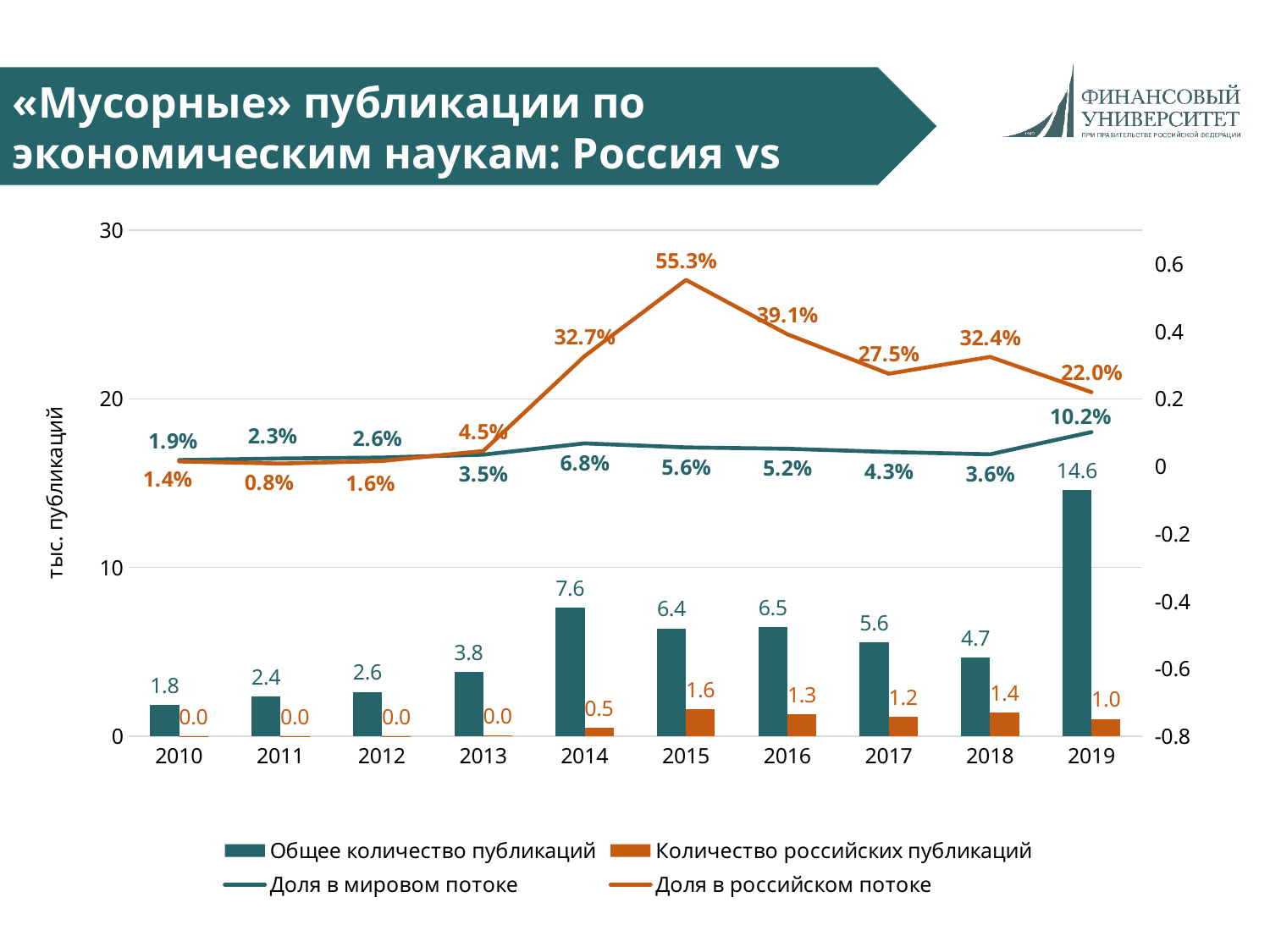
How many series does the legend list? 4 What is the label of the left vertical axis? тыс. публикаций How many years are shown on the x axis? 10 What is the value of «Доля в мировом потоке» for 2014? 6.8% What is the value of «Доля в российском потоке» for 2015? 55.3% What is the value of «Общее количество публикаций» for 2019? 14.6 In which year is «Общее количество публикаций» lowest? 2010 What kind of chart is this? Combined bar and line chart What is the difference between «Общее количество публикаций» in 2019 and in 2018? 9.9 Which is larger: «Количество российских публикаций» in 2015 or in 2016? 2015 In which year is «Доля в российском потоке» highest? 2015 What is the value of «Количество российских публикаций» for 2018? 1.4